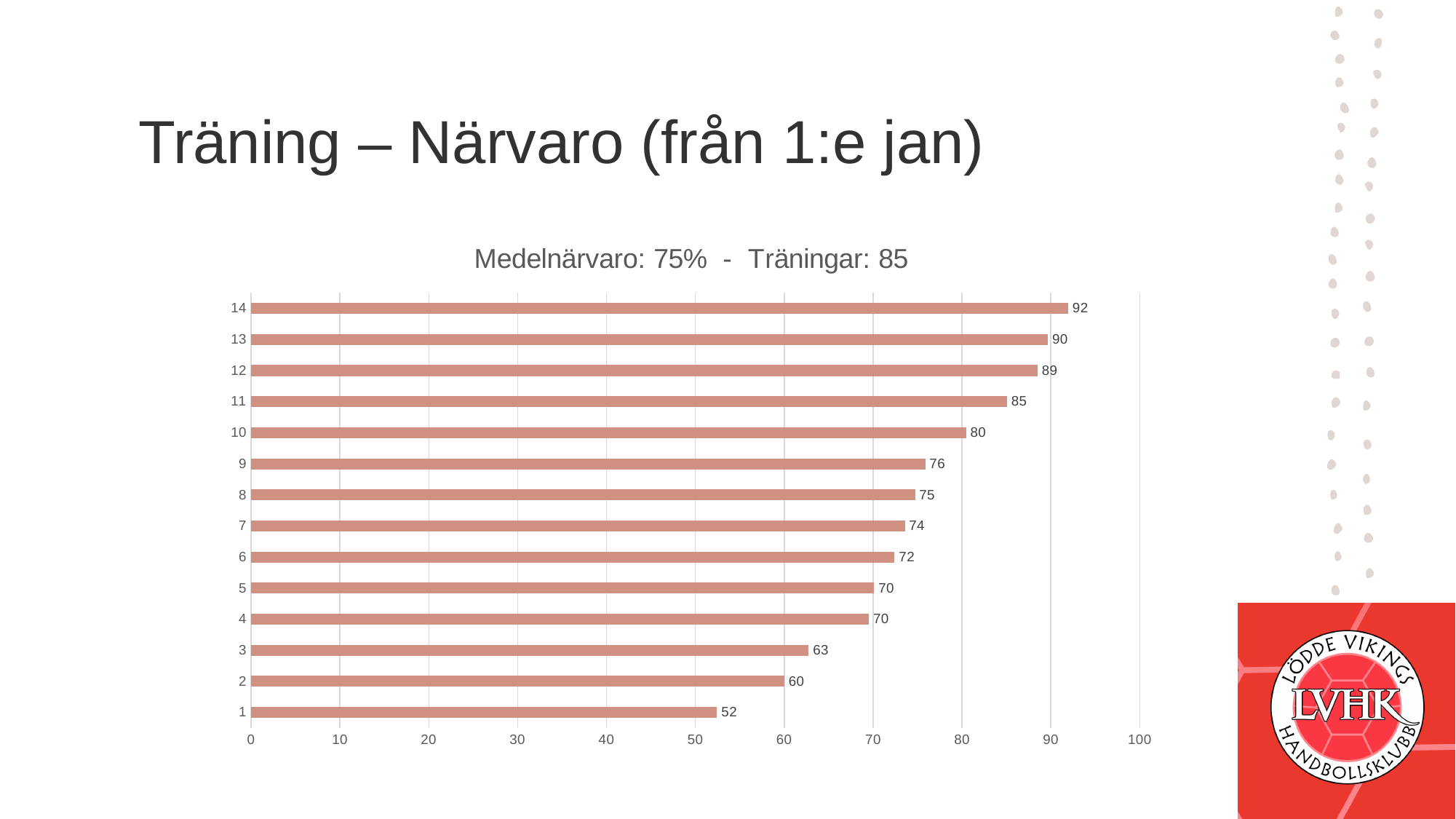
What kind of chart is shown on the slide? bar chart What is the difference between the values for category 14 and category 1? 40 Is the value for category 2 greater or less than 70? less Which has a larger value, category 12 or category 6? 12 Which category has the highest value? 14 What is the value for category 3? 63 How many categories are shown in the chart? 14 What is the difference between the values for category 11 and category 10? 5 Which category has the lowest value? 1 What is the value for category 9? 76 What is the value for category 14? 92 What is the title of the chart? Medelnärvaro: 75% - Träningar: 85